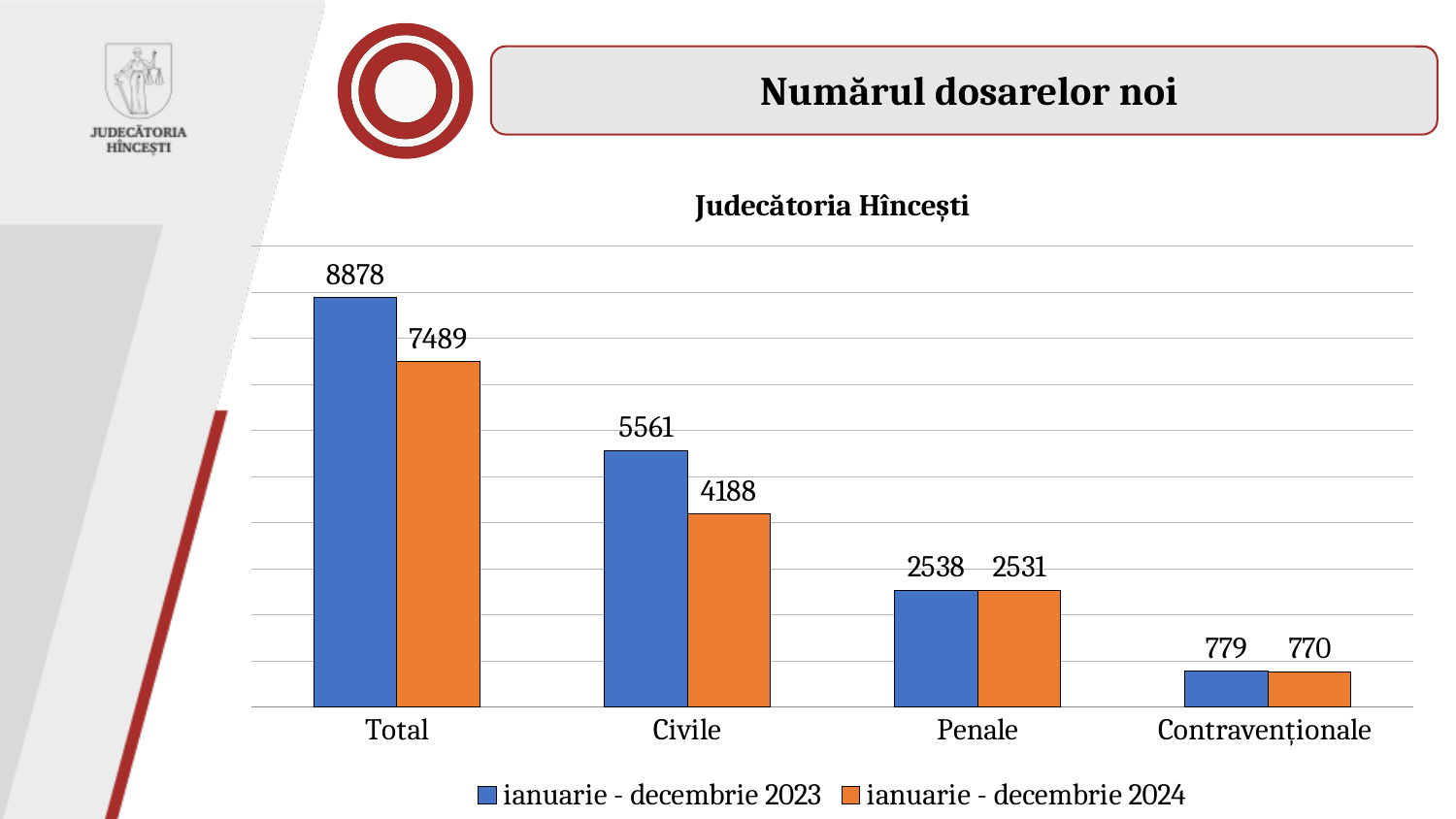
How many categories are shown on the x axis? 4 Which category has the lowest value in the ianuarie - decembrie 2023 series? Contravenționale What is the value for Penale in the ianuarie - decembrie 2024 series? 2531 Which is larger for Civile: the ianuarie - decembrie 2023 value or the ianuarie - decembrie 2024 value? ianuarie - decembrie 2023 What is the value for Contravenționale in the ianuarie - decembrie 2023 series? 779 Which category has the highest value in the ianuarie - decembrie 2024 series? Total How many series does the legend list? 2 What is the title of the chart? Judecătoria Hîncești What is the value for Civile in the ianuarie - decembrie 2023 series? 5561 What kind of chart is shown on the slide? Bar chart What is the difference between the Civile values for ianuarie - decembrie 2023 and ianuarie - decembrie 2024? 1373 What is the difference between the Total values for ianuarie - decembrie 2023 and ianuarie - decembrie 2024? 1389